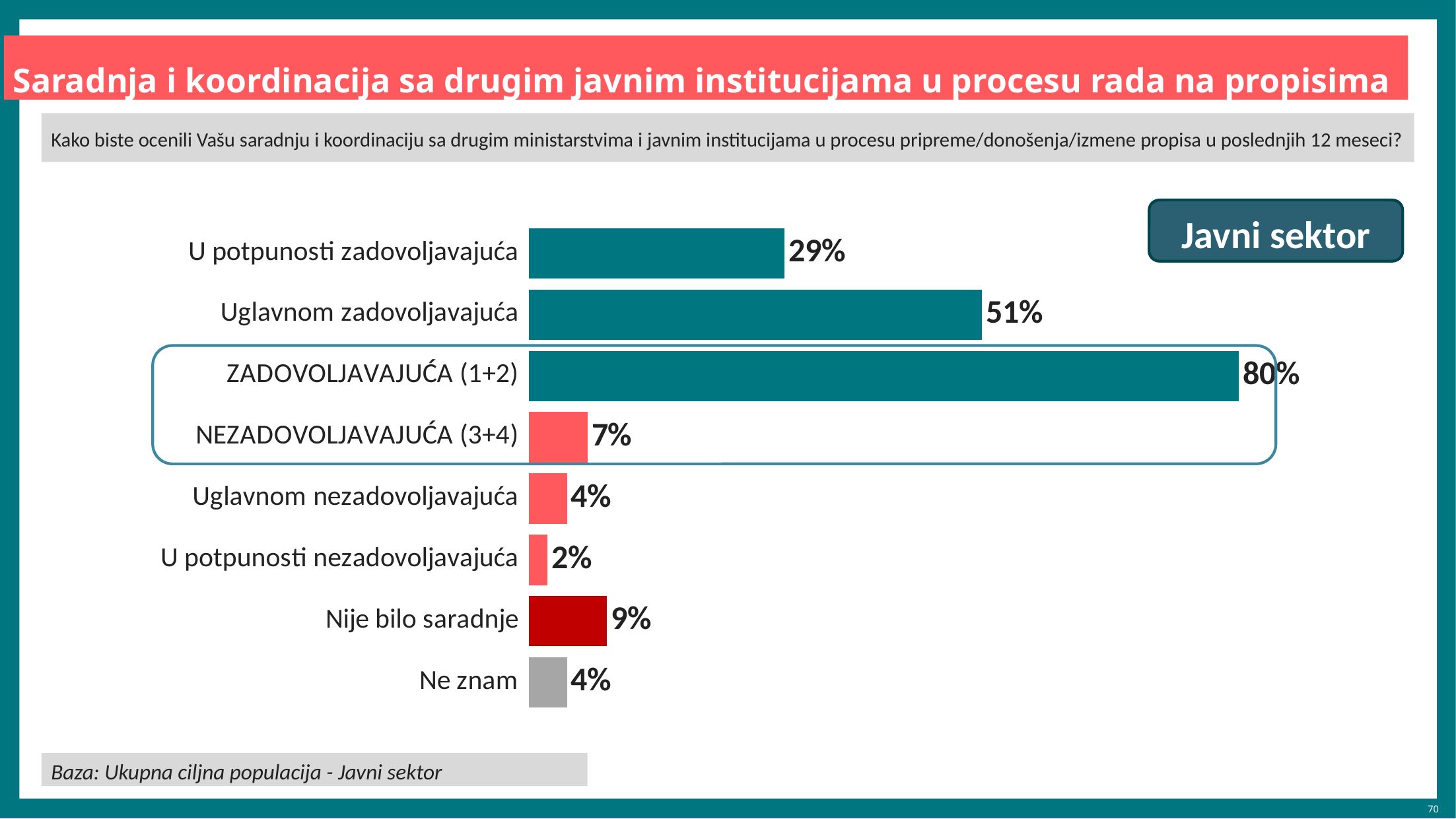
What is the value for "Uglavnom zadovoljavajuća"? 51% How many categories are shown in the chart? 8 What is the value for "Nije bilo saradnje"? 9% Which category has the highest value? ZADOVOLJAVAJUĆA (1+2) What is the difference between "Uglavnom zadovoljavajuća" and "U potpunosti zadovoljavajuća"? 22% What is the value for "U potpunosti zadovoljavajuća"? 29% What is the value for "NEZADOVOLJAVAJUĆA (3+4)"? 7% What is the value for "Ne znam"? 4% Which category has the lowest value? U potpunosti nezadovoljavajuća Which is larger, "Nije bilo saradnje" or "Uglavnom nezadovoljavajuća"? Nije bilo saradnje What is the label in the box at the top right of the chart? Javni sektor What kind of chart is shown on the slide? Bar chart